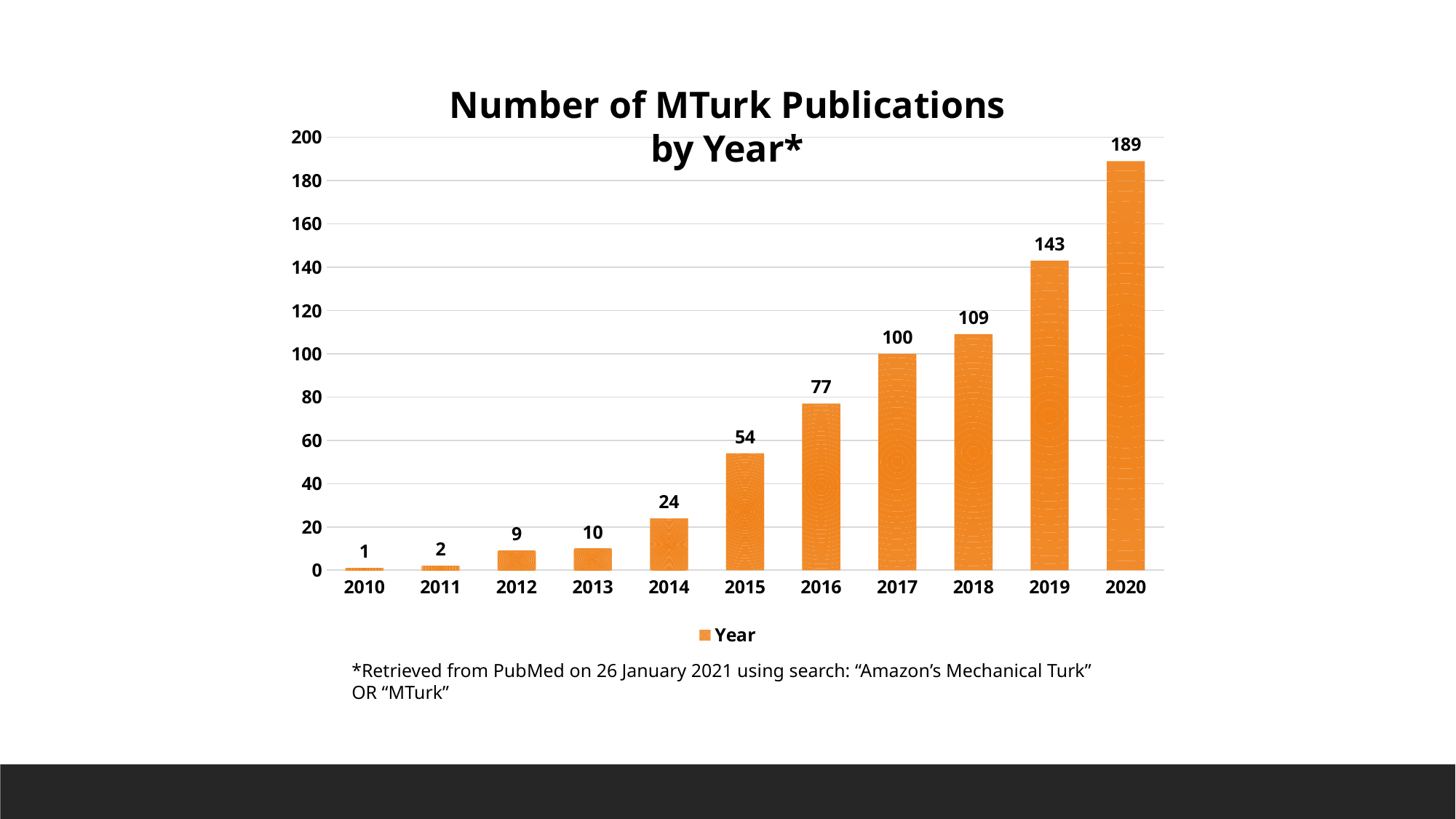
What is the difference between the values for 2017 and 2016? 23 How many MTurk publications were there in 2020? 189 Which year has the highest number of publications? 2020 What is the difference between the values for 2020 and 2019? 46 What is the value shown for 2012? 9 Which is larger, the value for 2018 or the value for 2014? 2018 Which year has the lowest number of publications? 2010 What is the value shown for 2015? 54 What kind of chart is this? Bar chart What is the title of the chart? Number of MTurk Publications by Year* Do the values rise or fall from 2010 to 2020? Rise How many years are shown on the x axis? 11